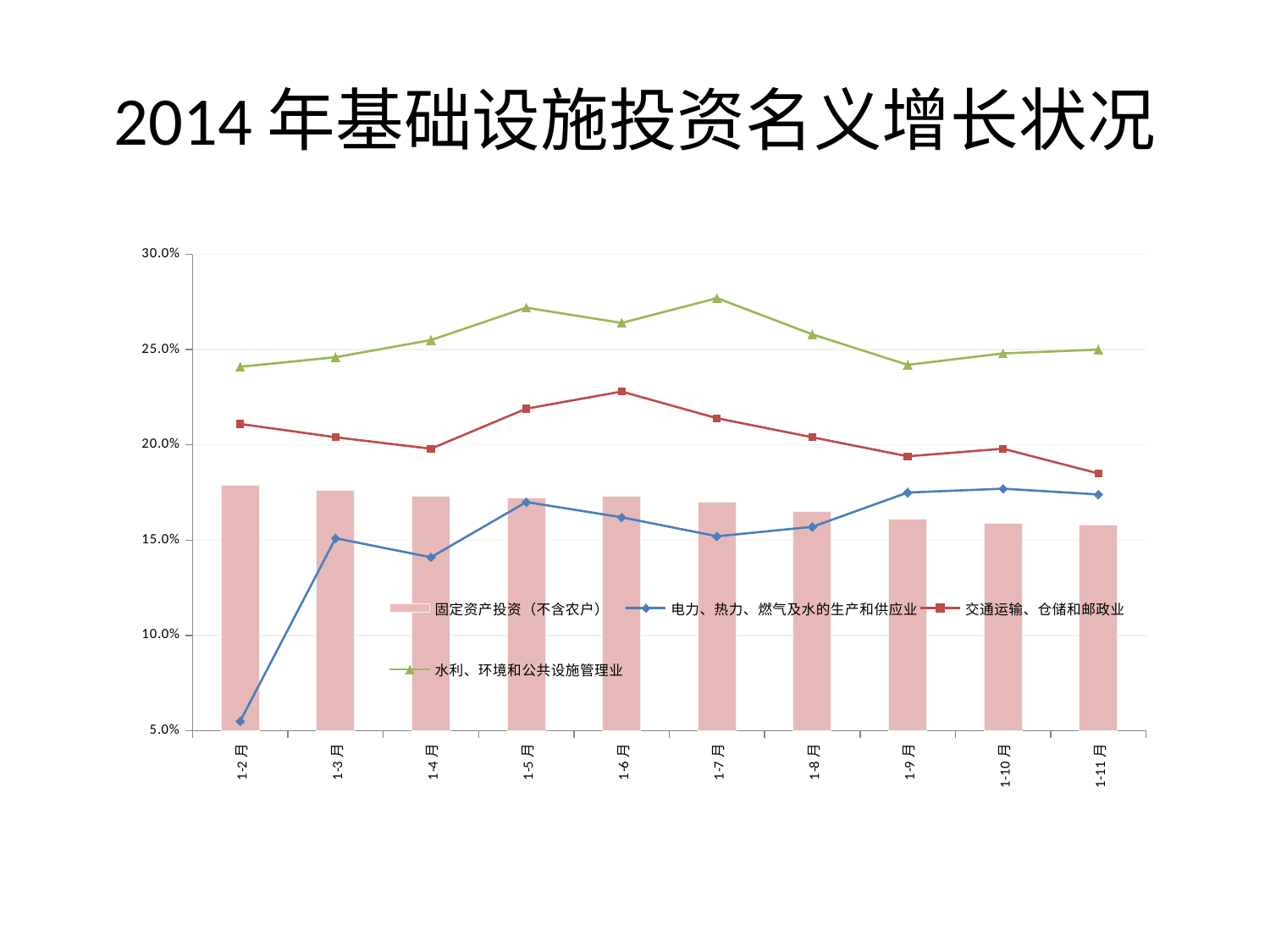
Which series is plotted as bars? 固定资产投资（不含农户） What kind of chart is shown on the slide? A combined bar and line chart In which period is the value for 固定资产投资（不含农户） highest? 1-2月 In which period is the value for 交通运输、仓储和邮政业 highest? 1-6月 Do the values for 固定资产投资（不含农户） generally rise or fall from 1-2月 to 1-11月? fall Which is larger in 1-11月: the value for 交通运输、仓储和邮政业 or the value for 固定资产投资（不含农户）? 交通运输、仓储和邮政业 In which period is the value for 电力、热力、燃气及水的生产和供应业 lowest? 1-2月 Is the value for 电力、热力、燃气及水的生产和供应业 in 1-2月 greater or less than 10.0%? less In which period is the value for 水利、环境和公共设施管理业 highest? 1-7月 How many series does the legend list? 4 Is the value for 水利、环境和公共设施管理业 in 1-5月 greater or less than 25.0%? greater How many periods are shown along the x axis? 10